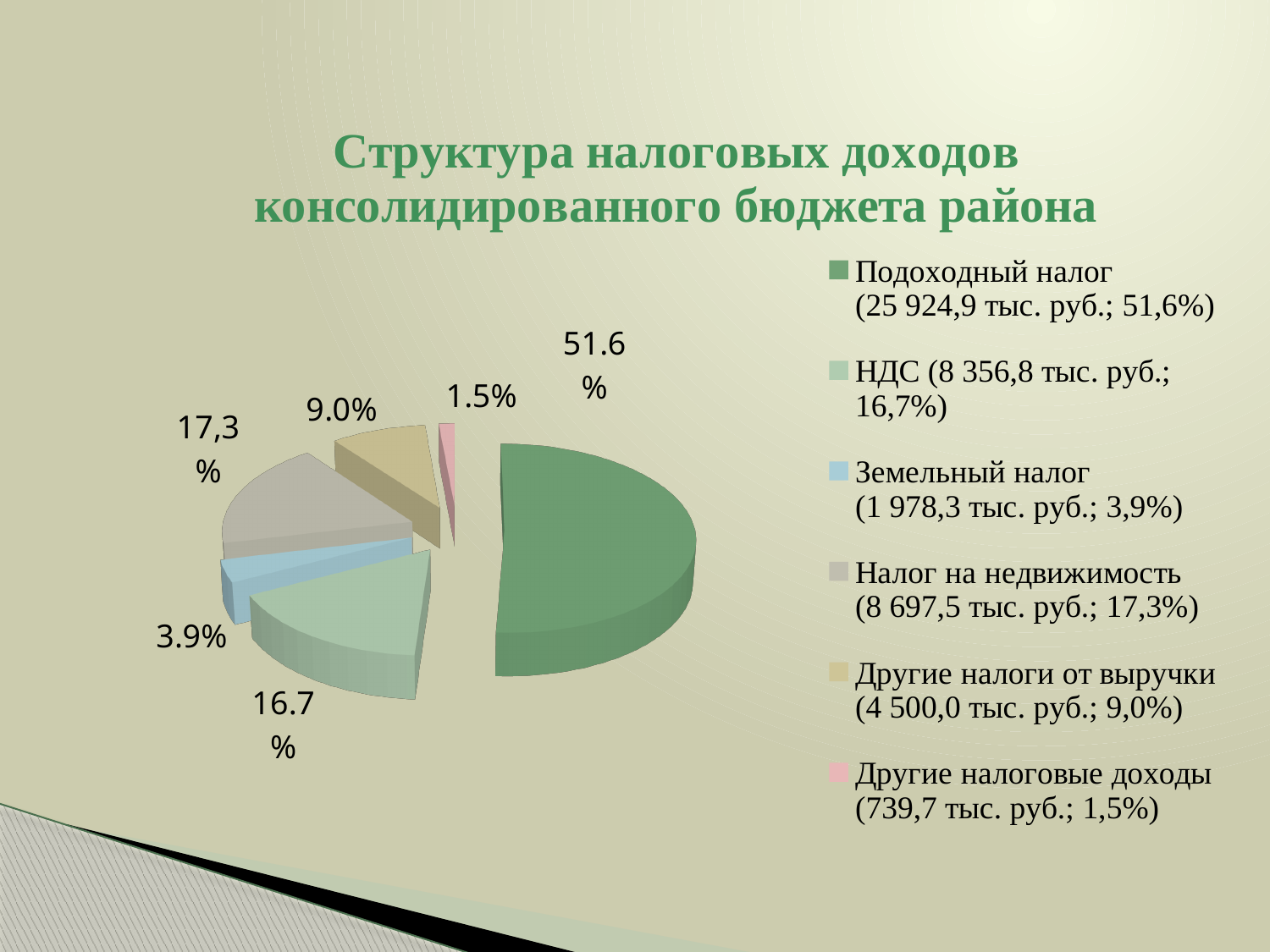
What share of the pie does Земельный налог have? 3.9% What share of the pie does НДС have? 16.7% What kind of chart is shown on the slide? pie chart Which category has the smallest slice of the pie? Другие налоговые доходы How many slices does the pie chart have? 6 How many entries does the legend list? 6 What share of the pie does Налог на недвижимость have? 17,3% What is the difference in percentage points between the share for Подоходный налог and the share for НДС? 34.9 Which category has the largest slice of the pie? Подоходный налог Which is larger, the share for Другие налоги от выручки or the share for Земельный налог? Другие налоги от выручки According to the legend, what amount in thousand rubles corresponds to Налог на недвижимость? 8 697,5 тыс. руб.